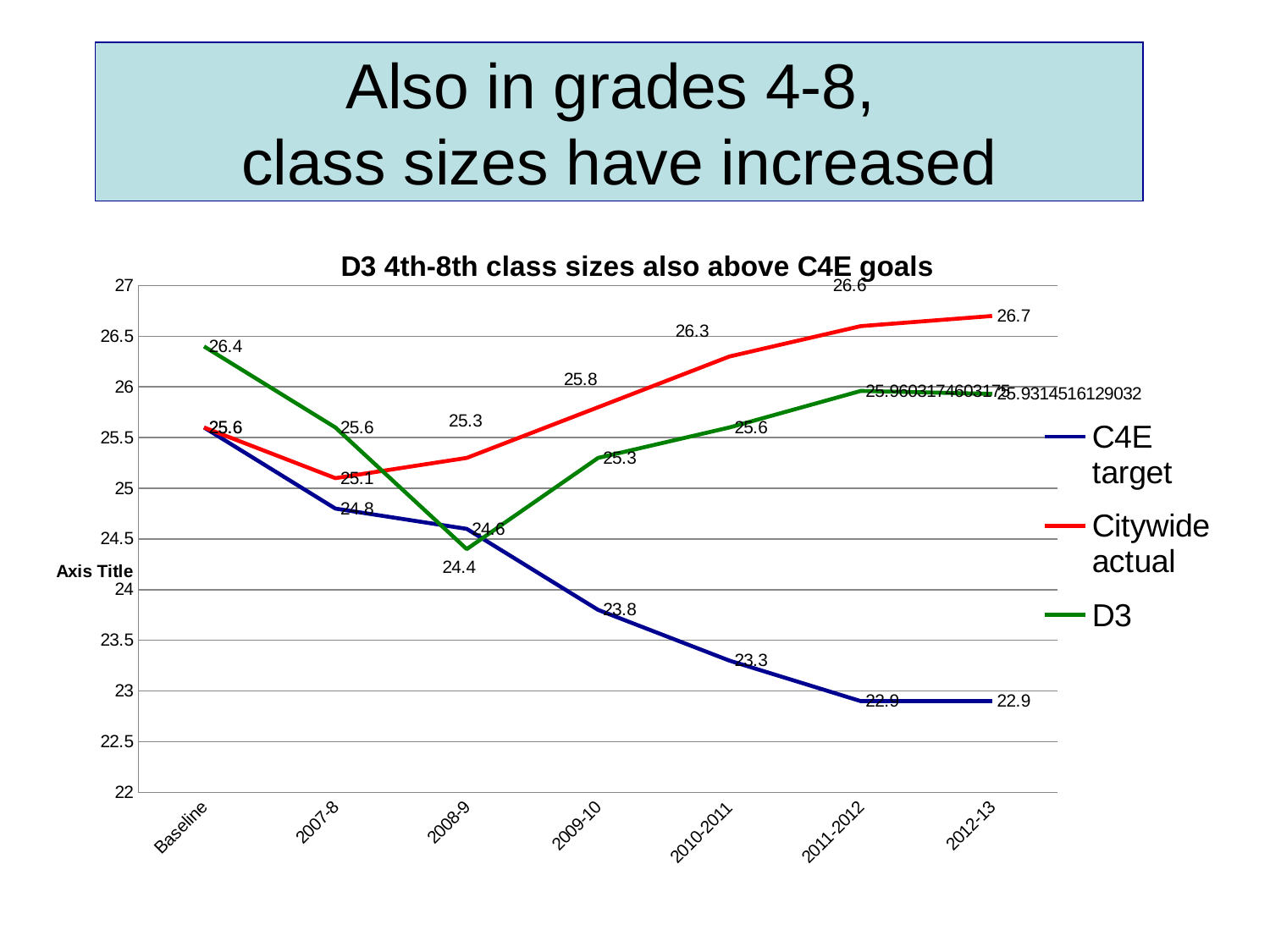
What is the Citywide actual value for 2012-13? 26.7 In which period is the Citywide actual value highest? 2012-13 What is the D3 value at Baseline? 26.4 How many series does the legend list? 3 In which period is the D3 value lowest? 2008-9 In 2010-2011, which is larger: the Citywide actual value or the D3 value? Citywide actual What is the difference between the Citywide actual value and the C4E target value in 2012-13? 3.8 What kind of chart is shown on the slide? line chart What is the C4E target value for 2009-10? 23.8 Does the C4E target line rise or fall from Baseline to 2012-13? fall How many points are plotted along the x axis for each series? 7 What is the Citywide actual value for 2007-8? 25.1